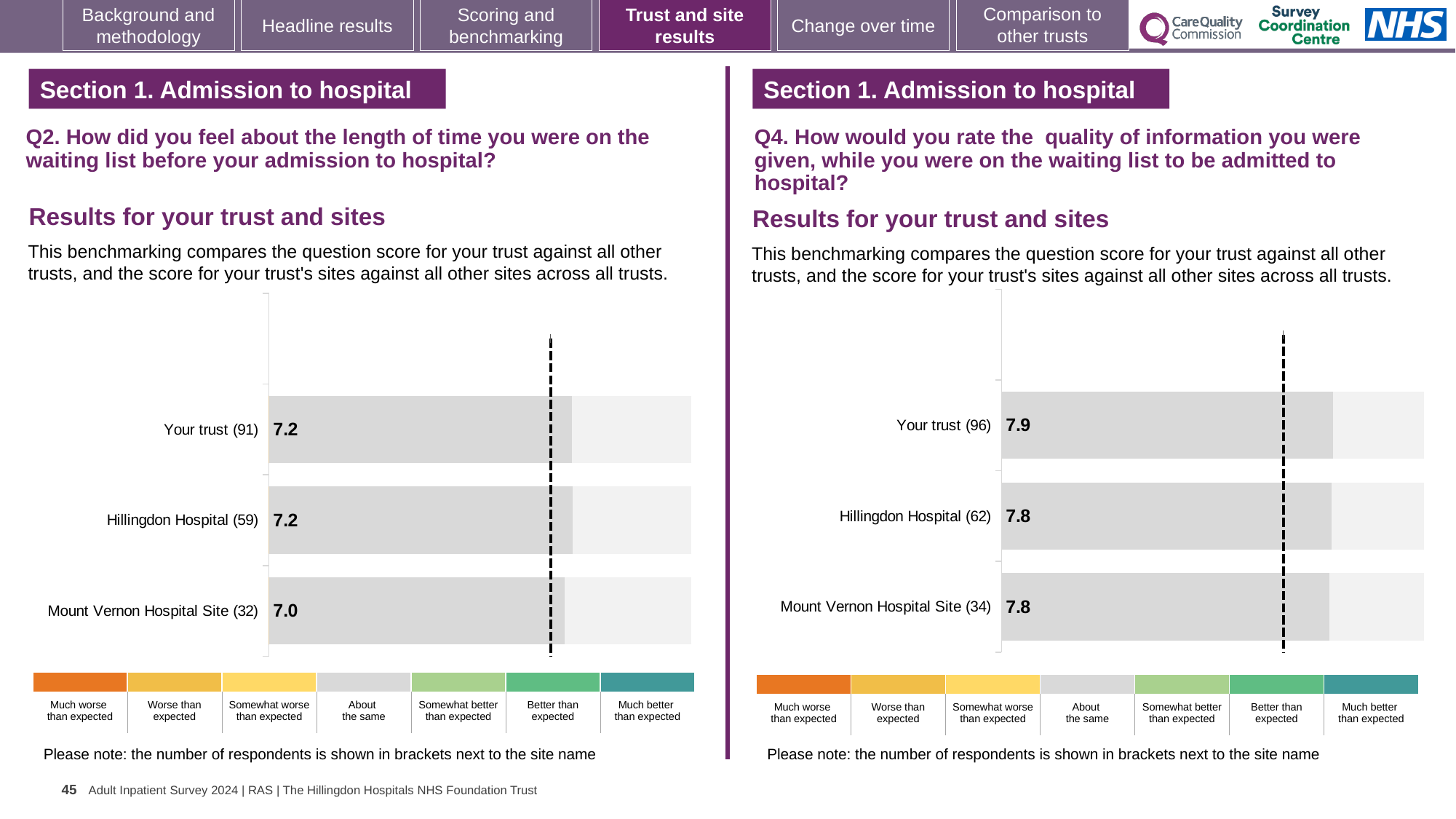
What kind of chart is used on the Q4 chart (right)? bar chart On the Q2 chart (left), what is the difference between the score for Your trust and the score for Mount Vernon Hospital Site? 0.2 On the Q4 chart (right), what is the score for Hillingdon Hospital? 7.8 On the Q2 chart (left), which category has the lowest score? Mount Vernon Hospital Site Is the Q4 score for Your trust (right chart) larger or smaller than the Q2 score for Your trust (left chart)? larger On the Q4 chart (right), how many respondents are shown in brackets for Hillingdon Hospital? 62 On the Q2 chart (left), what is the score for Your trust? 7.2 On the Q2 chart (left), what is the score for Mount Vernon Hospital Site? 7.0 How many categories (bars) are shown on the Q2 chart (left)? 3 On the Q4 chart (right), what is the difference between the score for Your trust and the score for Mount Vernon Hospital Site? 0.1 On the Q4 chart (right), which category has the highest score? Your trust On the Q4 chart (right), what is the score for Your trust? 7.9